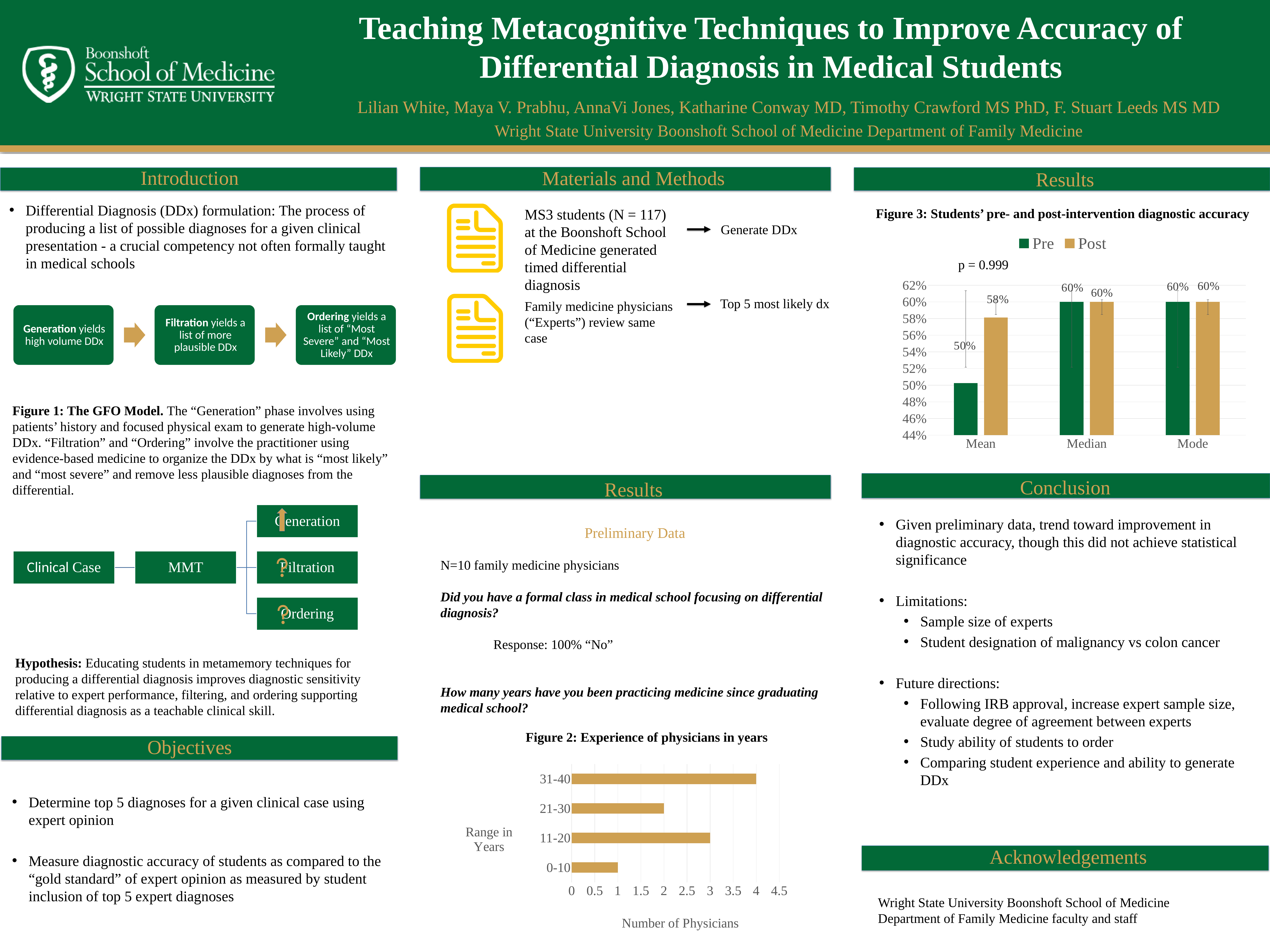
In Figure 2: Experience of physicians in years, how many range-in-years categories are shown? 4 In Figure 2: Experience of physicians in years, which range in years has the most physicians? 31-40 In Figure 3: Students' pre- and post-intervention diagnostic accuracy, what is the Pre value for Mean? 50% In Figure 2: Experience of physicians in years, what kind of chart is shown? bar chart In Figure 3: Students' pre- and post-intervention diagnostic accuracy, what is the Post value for Mean? 58% In Figure 2: Experience of physicians in years, which range in years has the fewest physicians? 0-10 In Figure 3: Students' pre- and post-intervention diagnostic accuracy, what is the difference between the Post and Pre values for Mean? 8% In Figure 3: Students' pre- and post-intervention diagnostic accuracy, how many series does the legend list? 2 In Figure 3: Students' pre- and post-intervention diagnostic accuracy, what p-value is shown on the chart? p = 0.999 In Figure 2: Experience of physicians in years, what is the difference in number of physicians between the 11-20 and 21-30 ranges? 1 In Figure 2: Experience of physicians in years, how many physicians are in the 31-40 range? 4 In Figure 2: Experience of physicians in years, how many physicians are in the 0-10 range? 1